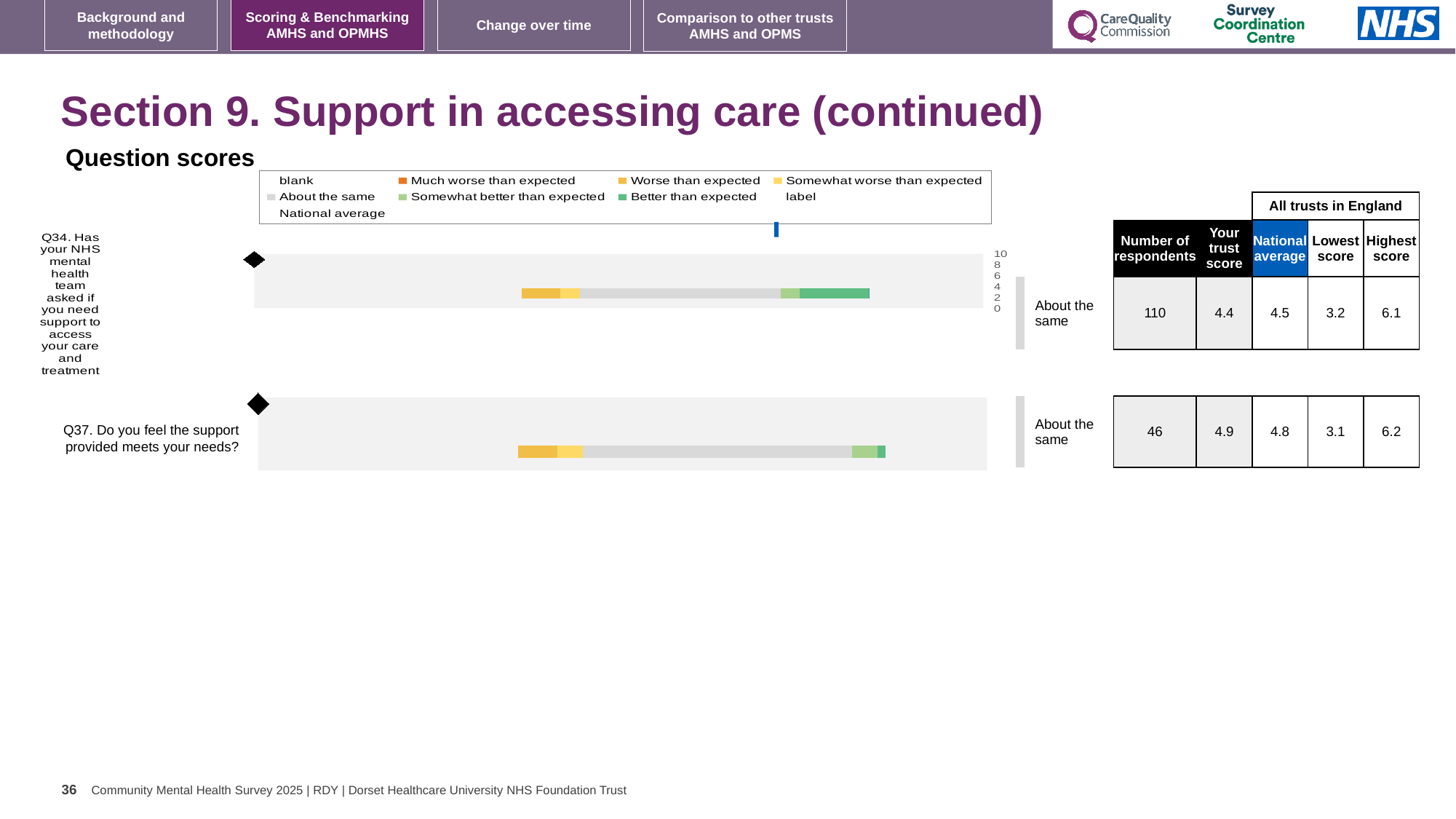
What is the trust score for Q34 (Has your NHS mental health team asked if you need support to access your care and treatment)? 4.4 Which question has more respondents, Q34 or Q37? Q34 What benchmark category is shown for Q37? About the same Which legend entry is shown in grey in the question scores chart? About the same What kind of chart is used to show the question scores on this slide? bar chart Which question has the higher trust score, Q34 or Q37? Q37 What is the trust score for Q37 (Do you feel the support provided meets your needs)? 4.9 What is the difference between the highest score (6.1) and the lowest score (3.2) for Q34? 2.9 What is the highest score among all trusts in England for Q37? 6.2 How many questions are plotted in the question scores chart? 2 How many respondents answered Q37? 46 What is the national average score for Q34? 4.5